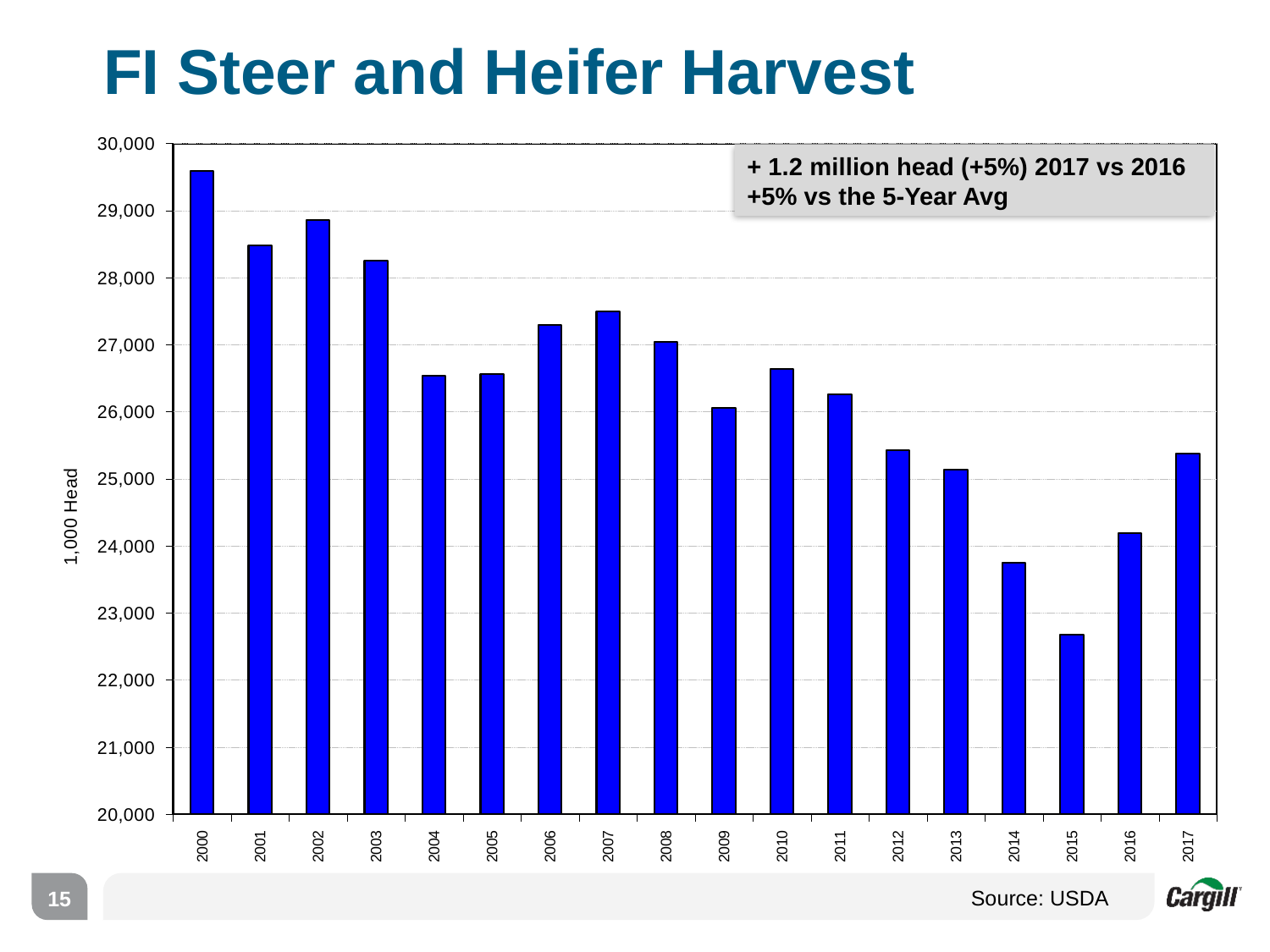
Which year has the larger harvest, 2002 or 2003? 2002 Is the value for 2000 greater or less than 29,000? greater Is the value for 2007 greater or less than 27,000? greater Which year has the highest FI steer and heifer harvest? 2000 What is the label on the vertical axis of the chart? 1,000 Head Is the value for 2015 greater or less than 23,000? less Which year has the lowest FI steer and heifer harvest? 2015 How many years are plotted on the chart? 18 Which year has the larger harvest, 2014 or 2016? 2016 Does the harvest generally rise or fall from 2000 to 2015? fall What kind of chart is shown on the slide? bar chart